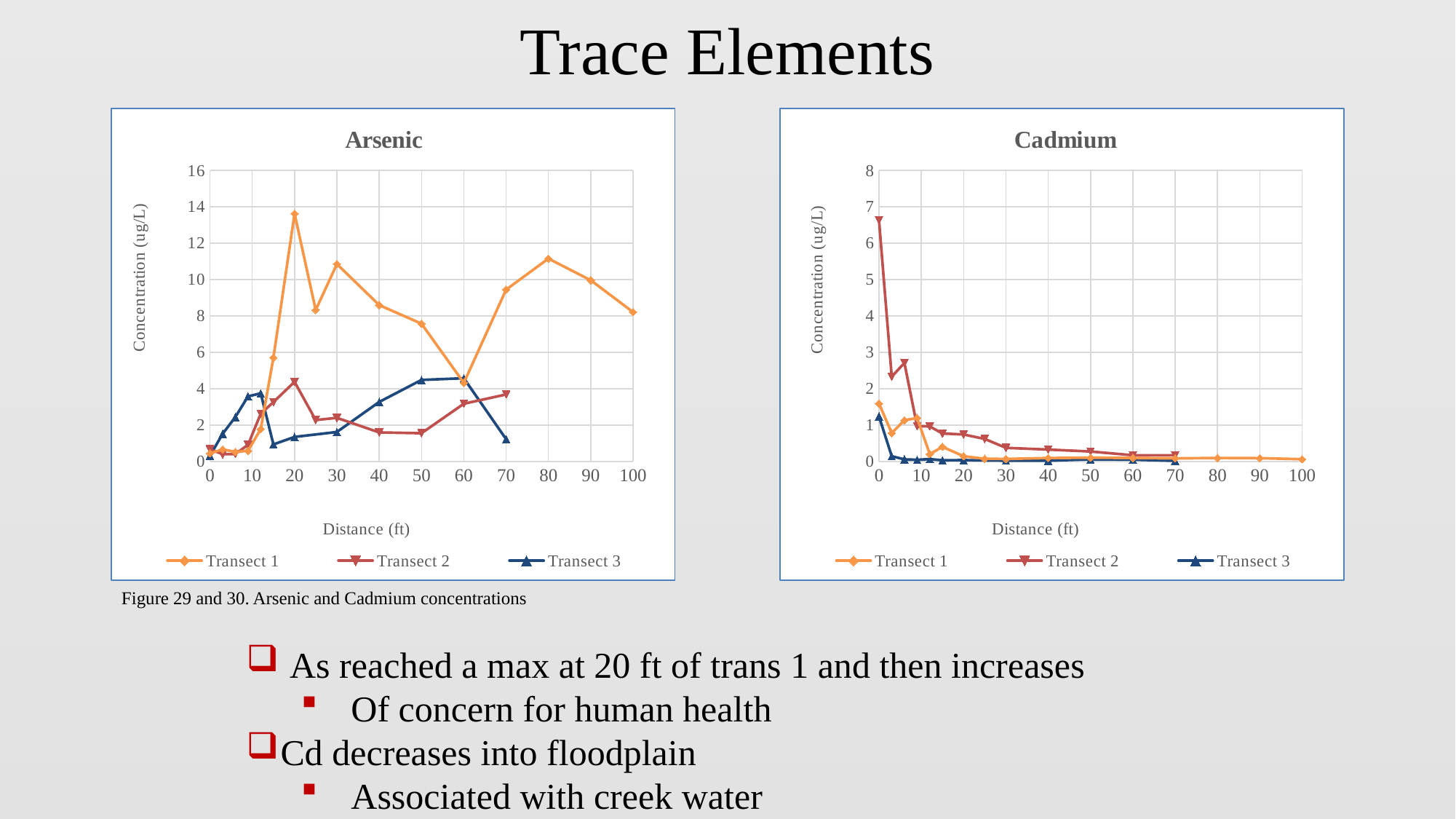
How many series does the legend of the Cadmium chart list? 3 What is the y-axis title of the Cadmium chart? Concentration (ug/L) In the Cadmium chart, is the value for Transect 2 at 0 ft greater or less than 6? greater In the Arsenic chart, which series reaches the highest concentration? Transect 1 What kind of chart is the Arsenic chart? line chart In the Arsenic chart, is the value for Transect 1 at 80 ft greater or less than 10? greater In the Arsenic chart, is the value for Transect 1 at 20 ft greater or less than 12? greater In the Cadmium chart, which series has the highest concentration at 0 ft? Transect 2 In the Cadmium chart, does the Transect 2 line generally rise or fall as distance increases? fall In the Arsenic chart, at 20 ft, which is larger: Transect 1 or Transect 2? Transect 1